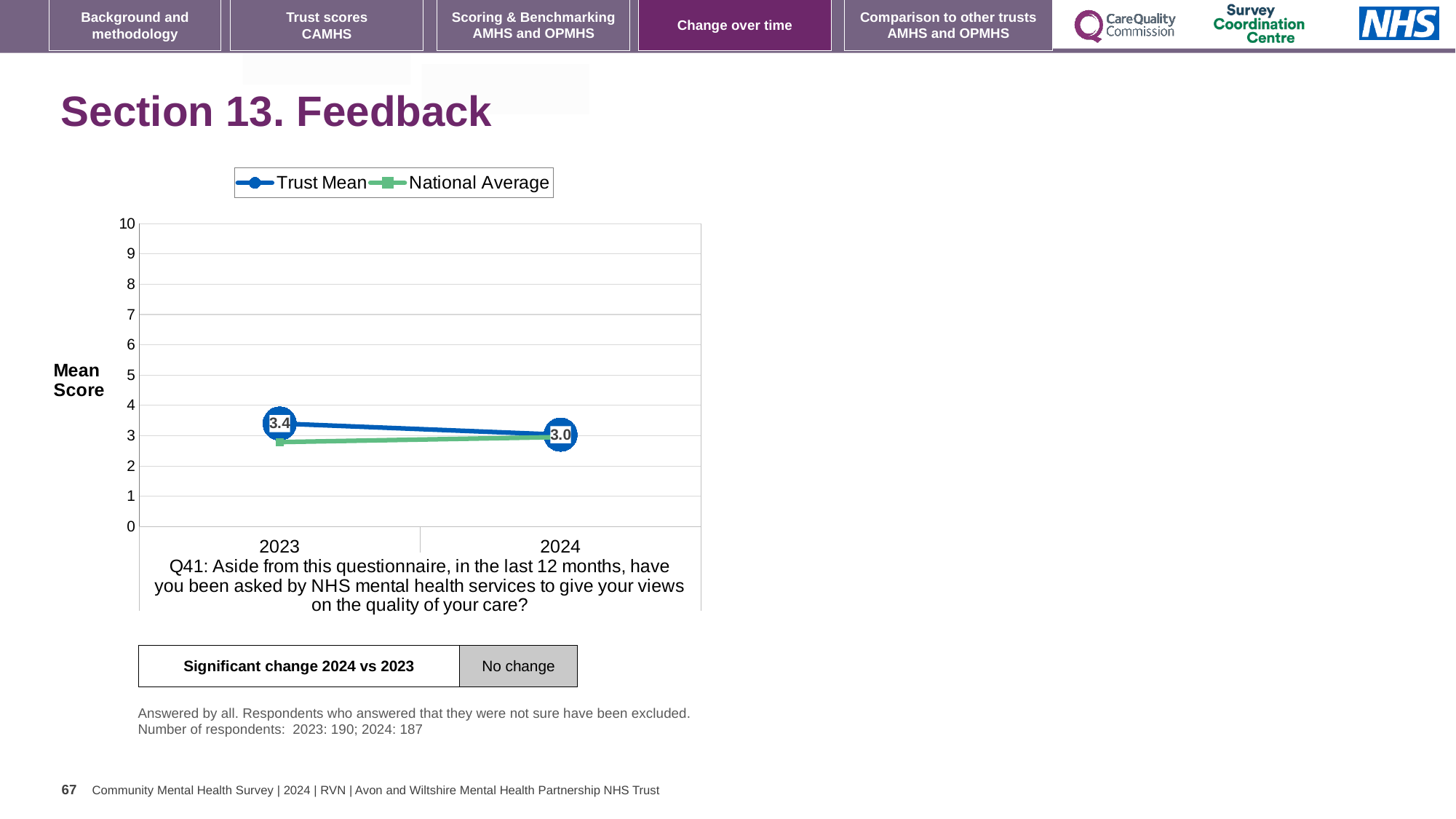
What is the Trust Mean value for 2023? 3.4 By how much did the Trust Mean change from 2023 to 2024? 0.4 In 2023, which is larger: the Trust Mean or the National Average? Trust Mean Is the National Average value for 2023 greater or less than 3? less Does the Trust Mean rise or fall from 2023 to 2024? fall In which year is the Trust Mean lowest? 2024 What is the Trust Mean value for 2024? 3.0 What kind of chart is shown on the slide? line chart How many series does the legend list? 2 In which year is the Trust Mean highest? 2023 How many years are plotted on the x axis? 2 What is the label on the y axis of the chart? Mean Score